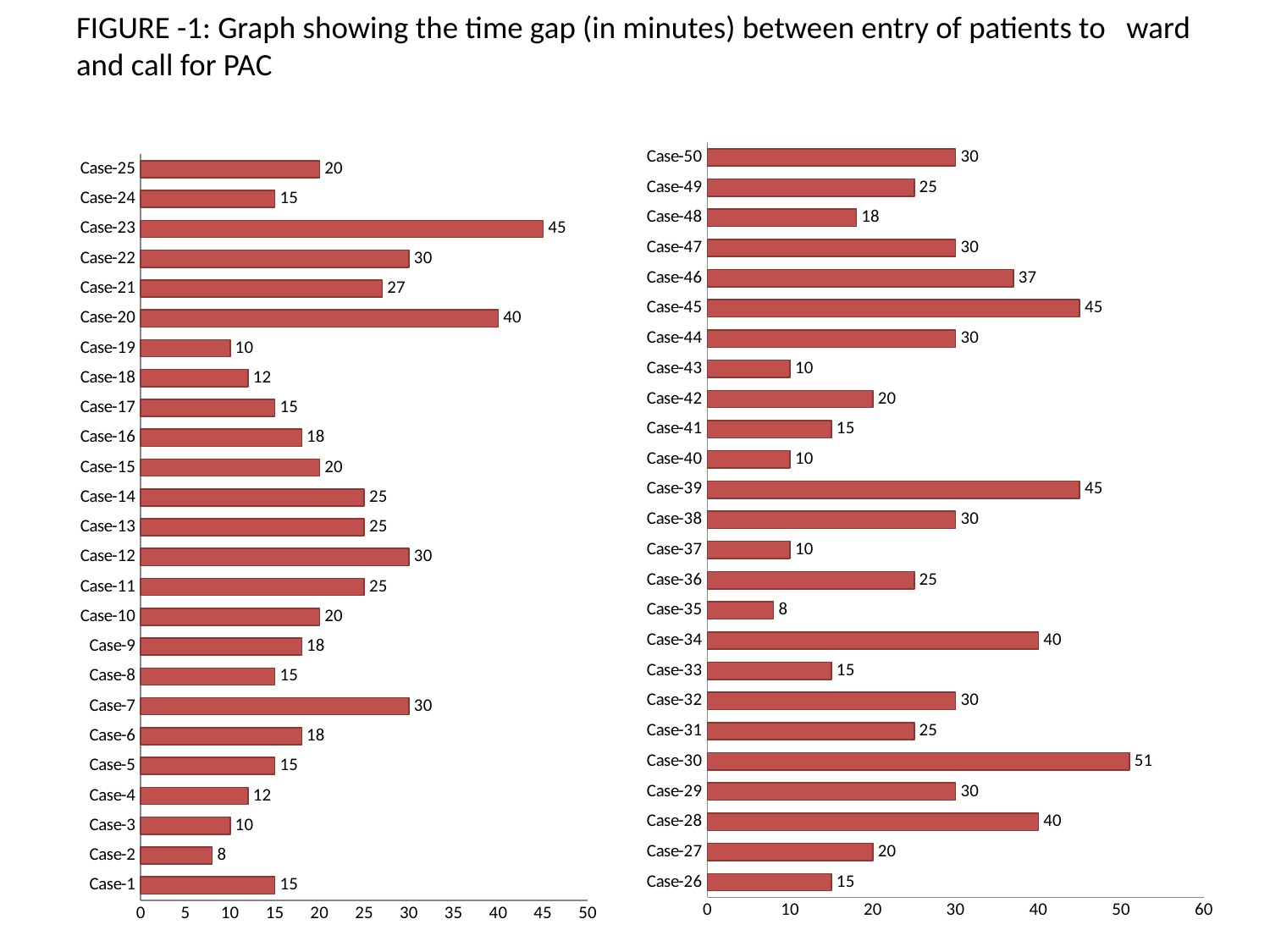
What kind of chart is the right chart (Case-26 to Case-50)? Bar chart In the right chart (Case-26 to Case-50), which case has the highest value? Case-30 In the right chart (Case-26 to Case-50), which is larger, the value for Case-39 or the value for Case-38? Case-39 In the left chart (Case-1 to Case-25), which case has the highest value? Case-23 In the right chart (Case-26 to Case-50), what is the value for Case-46? 37 In the left chart (Case-1 to Case-25), what is the value for Case-23? 45 How many cases are plotted in the left chart (Case-1 to Case-25)? 25 In the left chart (Case-1 to Case-25), which case has the lowest value? Case-2 In the left chart (Case-1 to Case-25), what is the value for Case-21? 27 In the left chart (Case-1 to Case-25), what is the difference between the values for Case-20 and Case-21? 13 In the right chart (Case-26 to Case-50), what is the difference between the values for Case-30 and Case-28? 11 In the right chart (Case-26 to Case-50), which case has the lowest value? Case-35